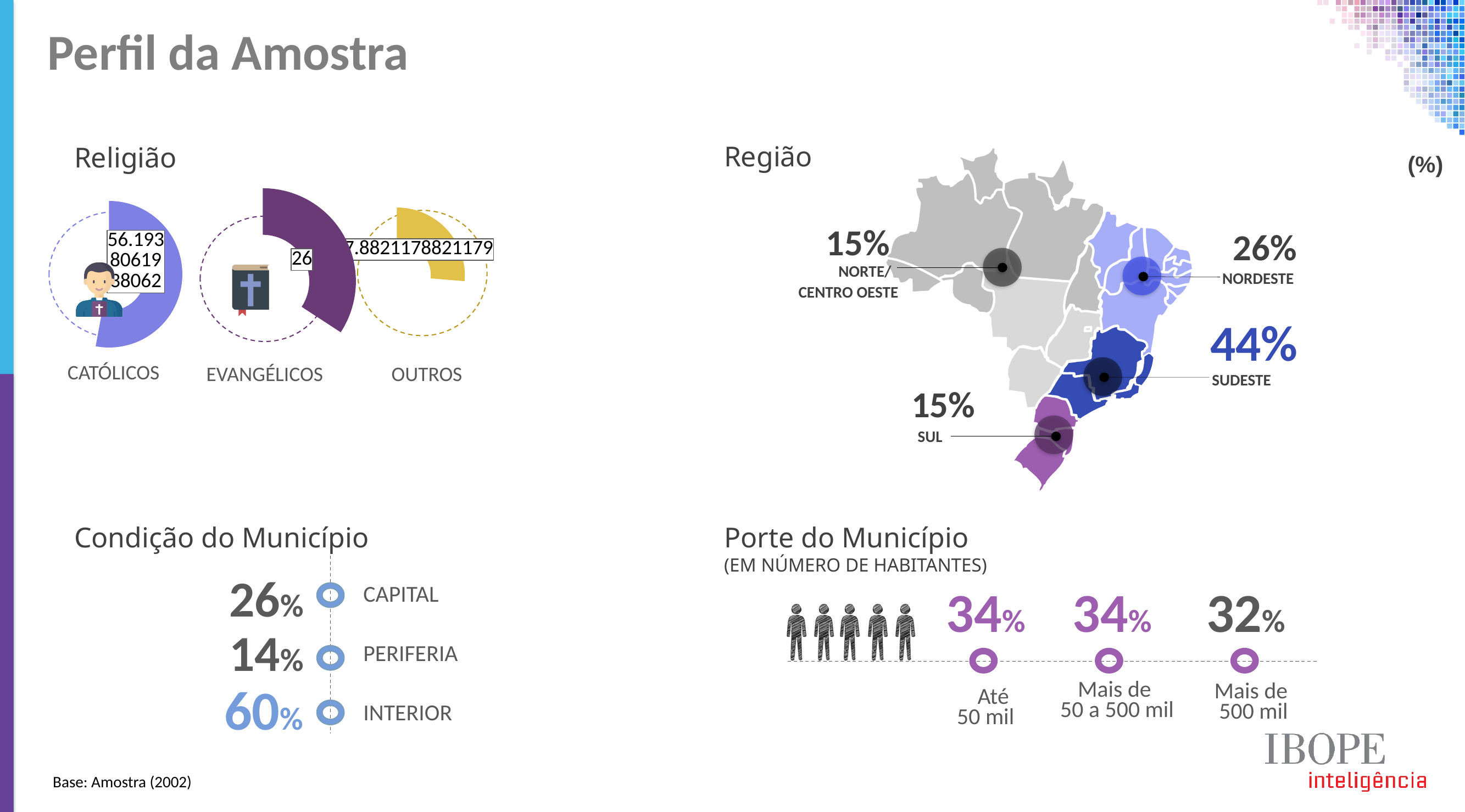
In the Porte do Município chart, what is the value for Mais de 500 mil? 32% In the Porte do Município chart, which is larger: Até 50 mil or Mais de 500 mil? Até 50 mil In the Região chart, what is the value for Sudeste? 44% In the Região chart, what is the value for Nordeste? 26% In the Porte do Município chart, how many categories are shown? 3 In the Condição do Município chart, what is the value for Interior? 60% In the Religião chart, what value is printed for Evangélicos? 26 In the Condição do Município chart, which category has the lowest value? Periferia In the Região chart, what is the difference between Sudeste and Nordeste? 18% In the Região chart, which region has the highest value? Sudeste In the Condição do Município chart, what is the difference between Capital and Periferia? 12% In the Religião chart, which category has the largest share? Católicos